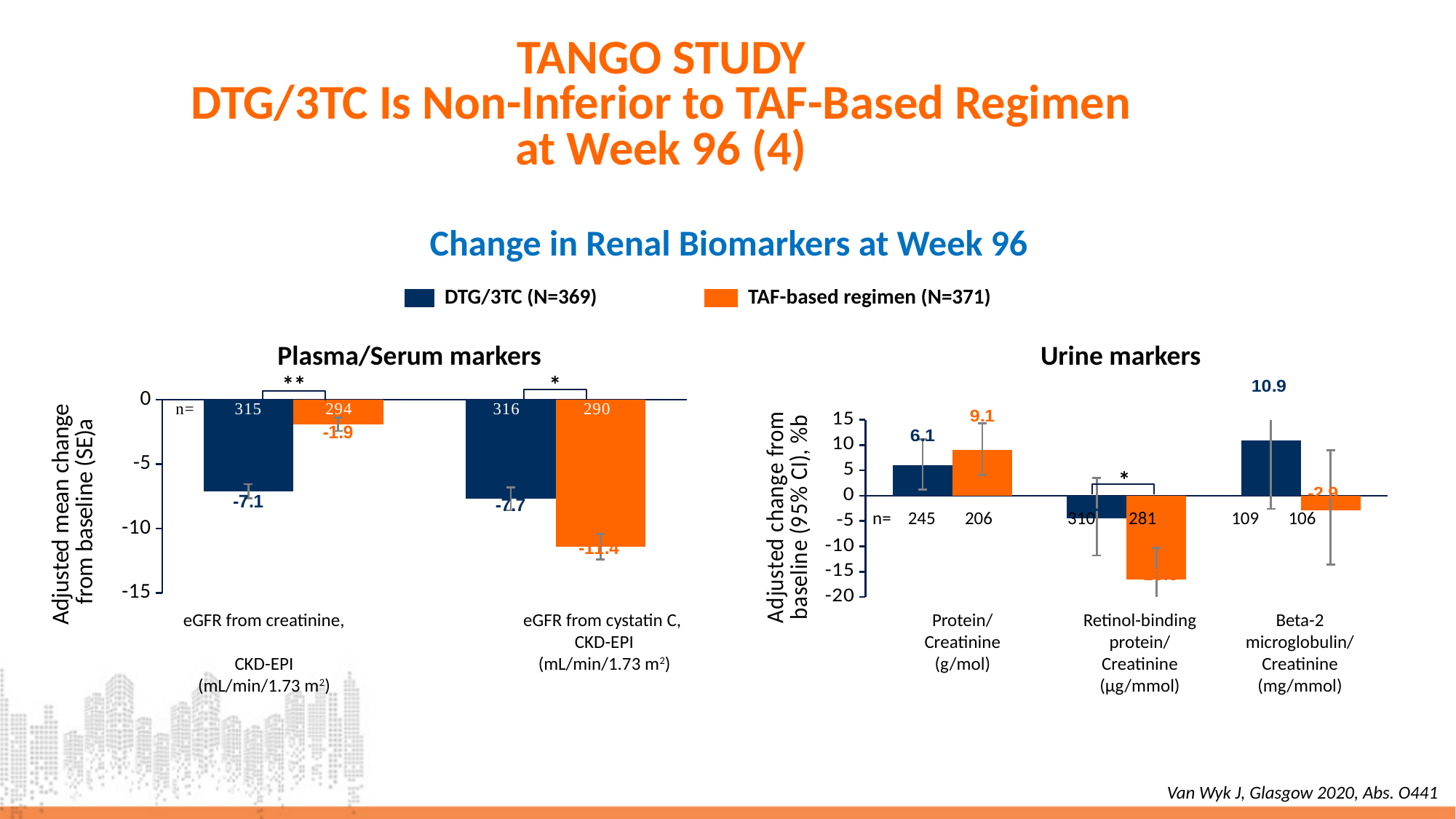
In the Plasma/Serum markers chart, what is the n for DTG/3TC in the eGFR from creatinine category? 315 In the Urine markers chart, what is the difference between the TAF-based regimen and DTG/3TC values for Protein/Creatinine? 3.0 In the Urine markers chart, what is the adjusted change from baseline in Protein/Creatinine for DTG/3TC? 6.1 In the Urine markers chart, is the value for the TAF-based regimen in Retinol-binding protein/Creatinine greater or less than -15? less How many series does the legend list? 2 In the Urine markers chart, which regimen has the larger change in Protein/Creatinine, DTG/3TC or the TAF-based regimen? TAF-based regimen In the Urine markers chart, what is the adjusted change from baseline in Beta-2 microglobulin/Creatinine for DTG/3TC? 10.9 In the Plasma/Serum markers chart, what is the adjusted mean change from baseline in eGFR from creatinine for DTG/3TC? -7.1 How many marker categories are shown in the Urine markers chart? 3 What kind of chart is the Urine markers chart? Bar chart In the Plasma/Serum markers chart, what is the adjusted mean change from baseline in eGFR from creatinine for the TAF-based regimen? -1.9 In the Urine markers chart, what is the adjusted change from baseline in Protein/Creatinine for the TAF-based regimen? 9.1